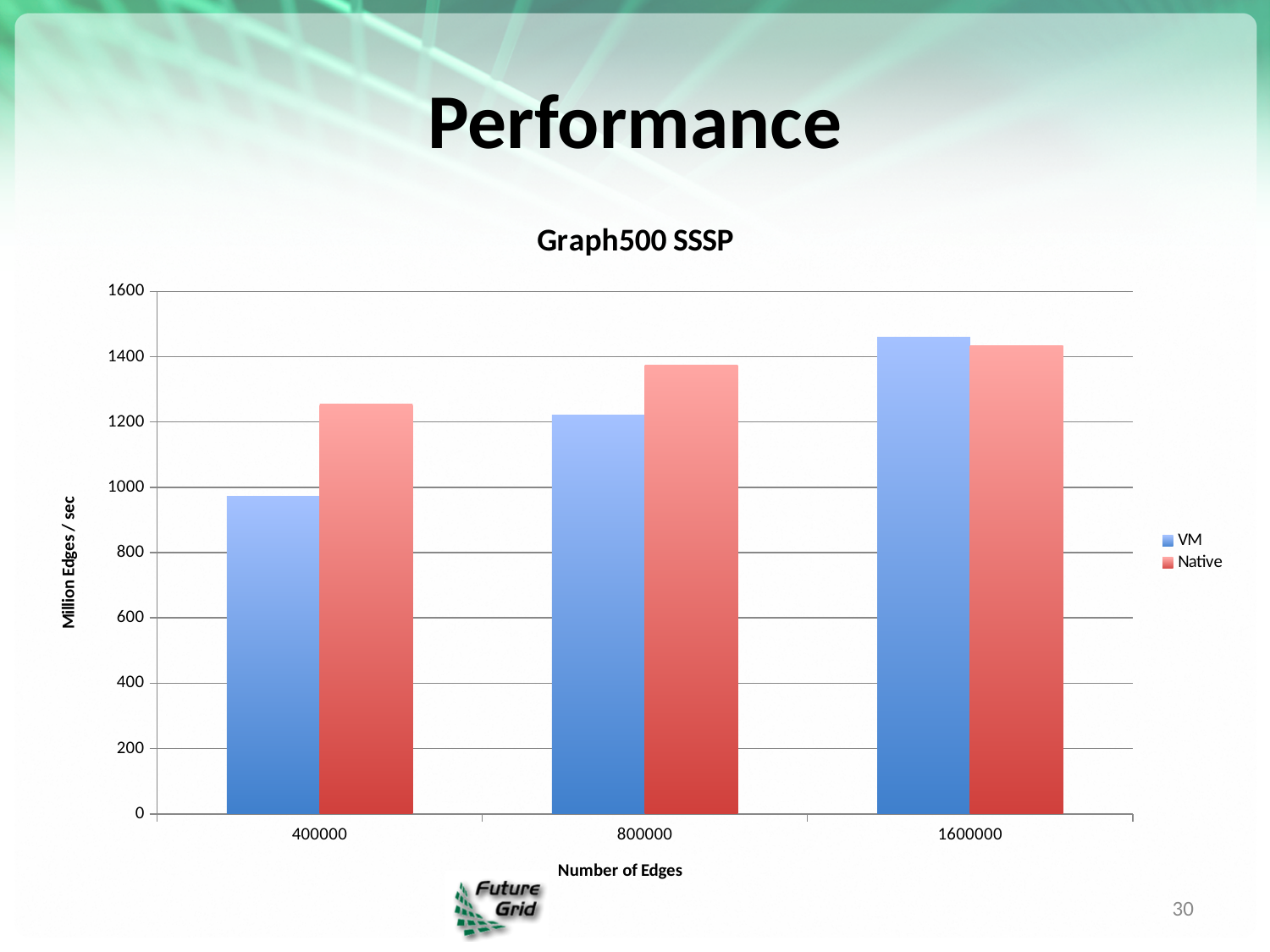
Is the VM value for 400000 edges greater or less than 1000? less What kind of chart is shown on the slide? bar chart Is the Native value for 400000 edges greater or less than 1200? greater For which number of edges is the VM value highest? 1600000 How many categories are shown on the x axis? 3 Is the VM value for 1600000 edges greater or less than 1400? greater How many series does the legend list? 2 What is the title of the chart? Graph500 SSSP At 400000 edges, which is larger, VM or Native? Native Do the VM values rise or fall as the number of edges increases? rise At 800000 edges, which is larger, VM or Native? Native